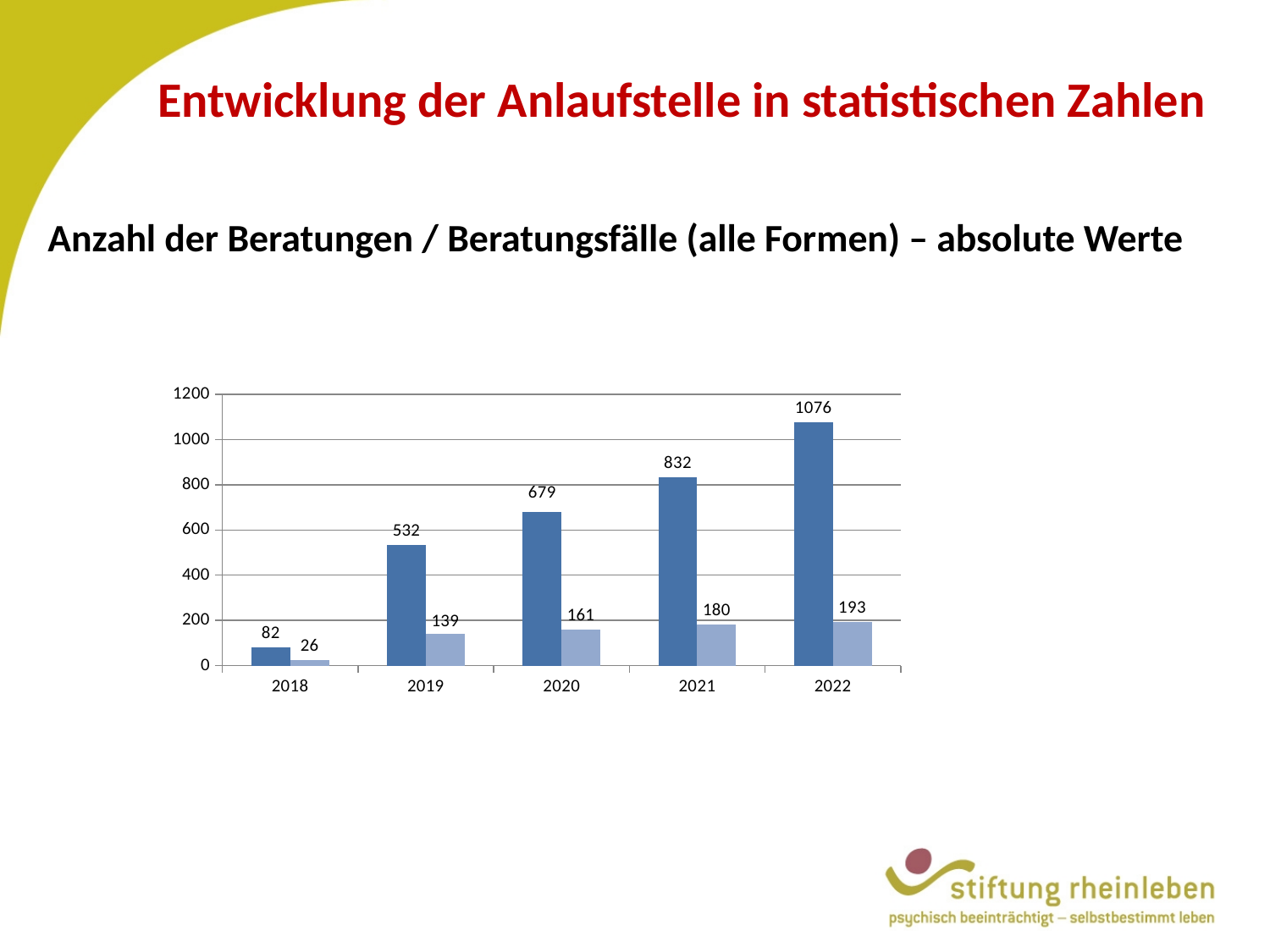
Which is larger, the light blue bar for 2021 or the light blue bar for 2020? 2021 What is the value of the light blue bar for 2019? 139 How many years are shown on the x axis? 5 Which year has the highest dark blue bar? 2022 What is the difference between the dark blue and light blue bar values for 2019? 393 Do the dark blue bar values rise or fall from 2018 to 2022? rise Which year has the lowest light blue bar? 2018 What is the value of the dark blue bar for 2022? 1076 What kind of chart is shown on the slide? bar chart What is the value of the dark blue bar for 2020? 679 What is the difference between the dark blue bar values for 2022 and 2021? 244 Is the dark blue bar for 2021 greater or less than 800? greater